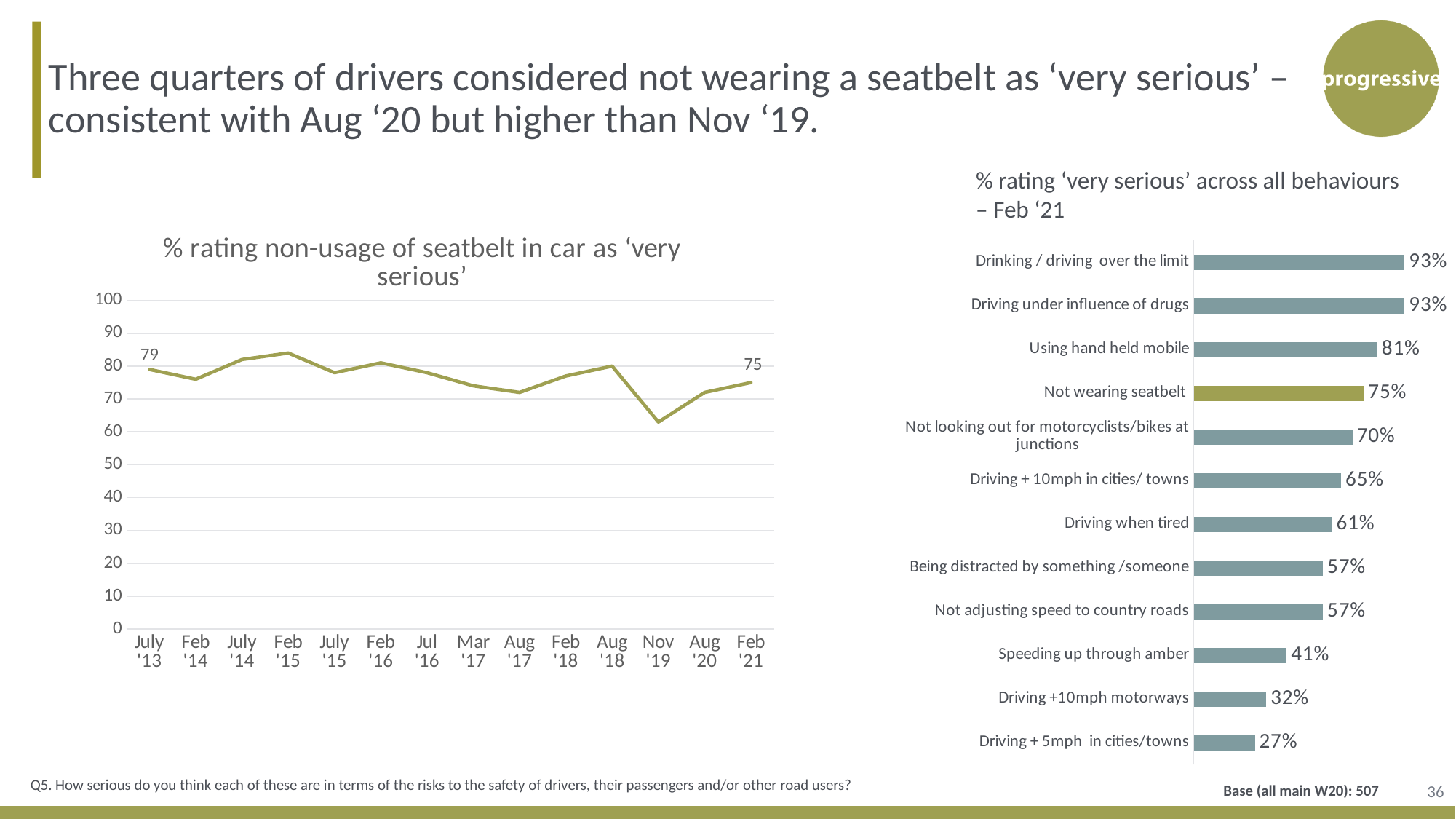
In the chart titled '% rating ‘very serious’ across all behaviours – Feb ‘21', which behaviour has the lowest value? Driving + 5mph in cities/towns In the chart titled '% rating ‘very serious’ across all behaviours – Feb ‘21', what is the value for Not wearing seatbelt? 75% In the chart titled '% rating non-usage of seatbelt in car as ‘very serious’', how many time points are plotted on the x axis? 14 In the chart titled '% rating non-usage of seatbelt in car as ‘very serious’', is the value for Nov '19 greater or less than 70? less In the chart titled '% rating ‘very serious’ across all behaviours – Feb ‘21', which is larger: Driving +10mph motorways or Driving + 10mph in cities/ towns? Driving + 10mph in cities/ towns In the chart titled '% rating non-usage of seatbelt in car as ‘very serious’', what is the value for July '13? 79 What kind of chart is the one on the left of the slide? line chart In the chart titled '% rating ‘very serious’ across all behaviours – Feb ‘21', what is the value for Speeding up through amber? 41% In the chart titled '% rating ‘very serious’ across all behaviours – Feb ‘21', how many behaviours are listed? 12 In the chart titled '% rating ‘very serious’ across all behaviours – Feb ‘21', what is the difference between Using hand held mobile and Driving when tired? 20% In the chart titled '% rating non-usage of seatbelt in car as ‘very serious’', what is the value for Feb '21? 75 In the chart titled '% rating ‘very serious’ across all behaviours – Feb ‘21', which bar is highlighted in a different colour from the others? Not wearing seatbelt